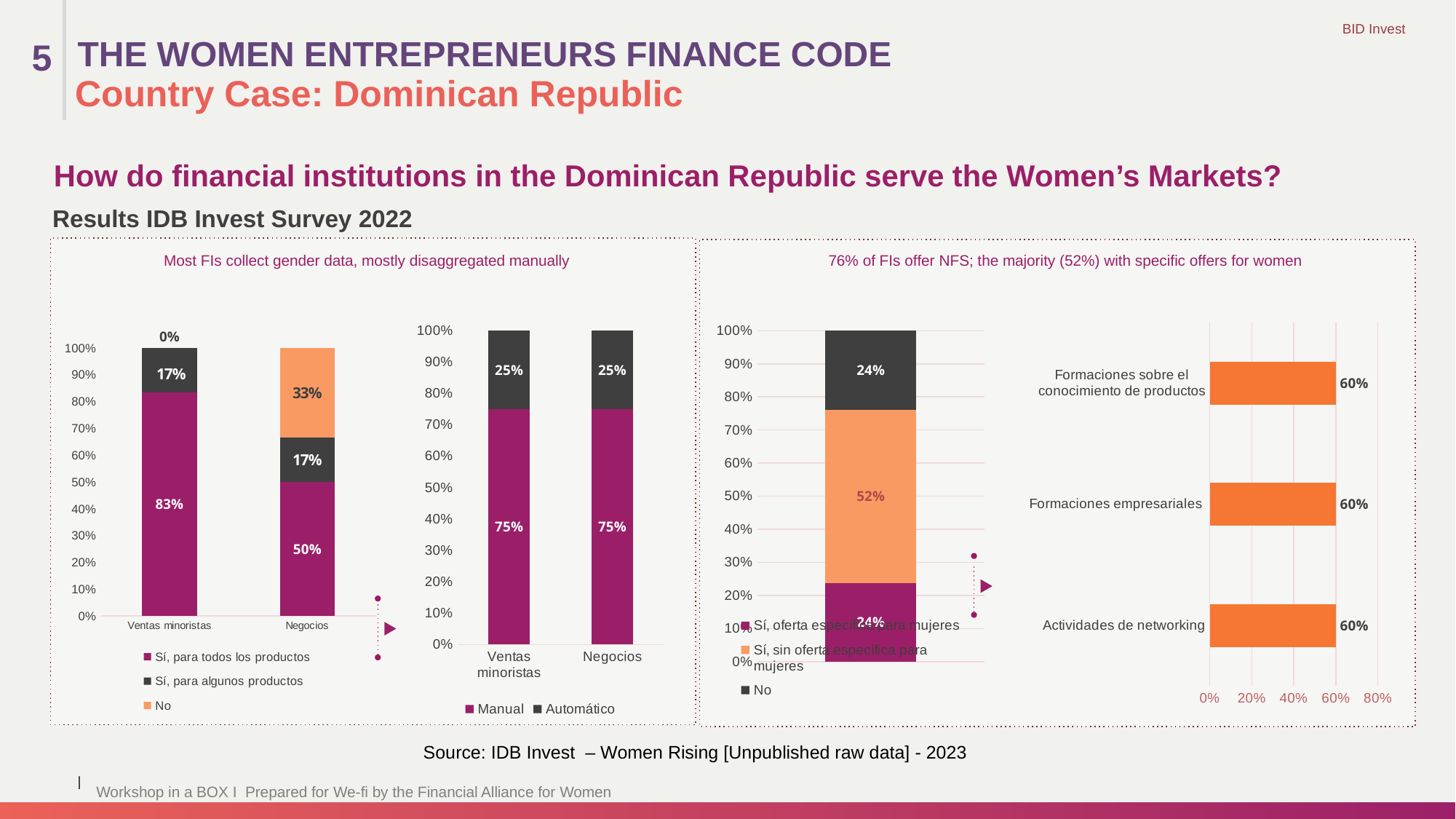
In the rightmost horizontal bar chart, how many categories are shown? 3 In the leftmost stacked bar chart, what is the difference between the 'Sí, para todos los productos' values for Ventas minoristas and Negocios? 33% In the leftmost stacked bar chart, what is the value of 'Sí, para todos los productos' for Ventas minoristas? 83% In the third chart from the left (NFS stacked bar), what is the value for 'No'? 24% In the leftmost stacked bar chart, what is the value of 'No' for Negocios? 33% In the second chart from the left (Manual/Automático), what is the Automático value for Ventas minoristas? 25% What kind of chart is the rightmost chart on the slide? Bar chart In the second chart from the left (Manual/Automático), how many categories are shown on the x axis? 2 In the rightmost horizontal bar chart, what is the value for Actividades de networking? 60% In the third chart from the left (NFS stacked bar), what is the value for 'Sí, sin oferta específica para mujeres'? 52% In the second chart from the left (Manual/Automático), what is the Manual value for Negocios? 75% In the leftmost stacked bar chart, how many series does the legend list? 3